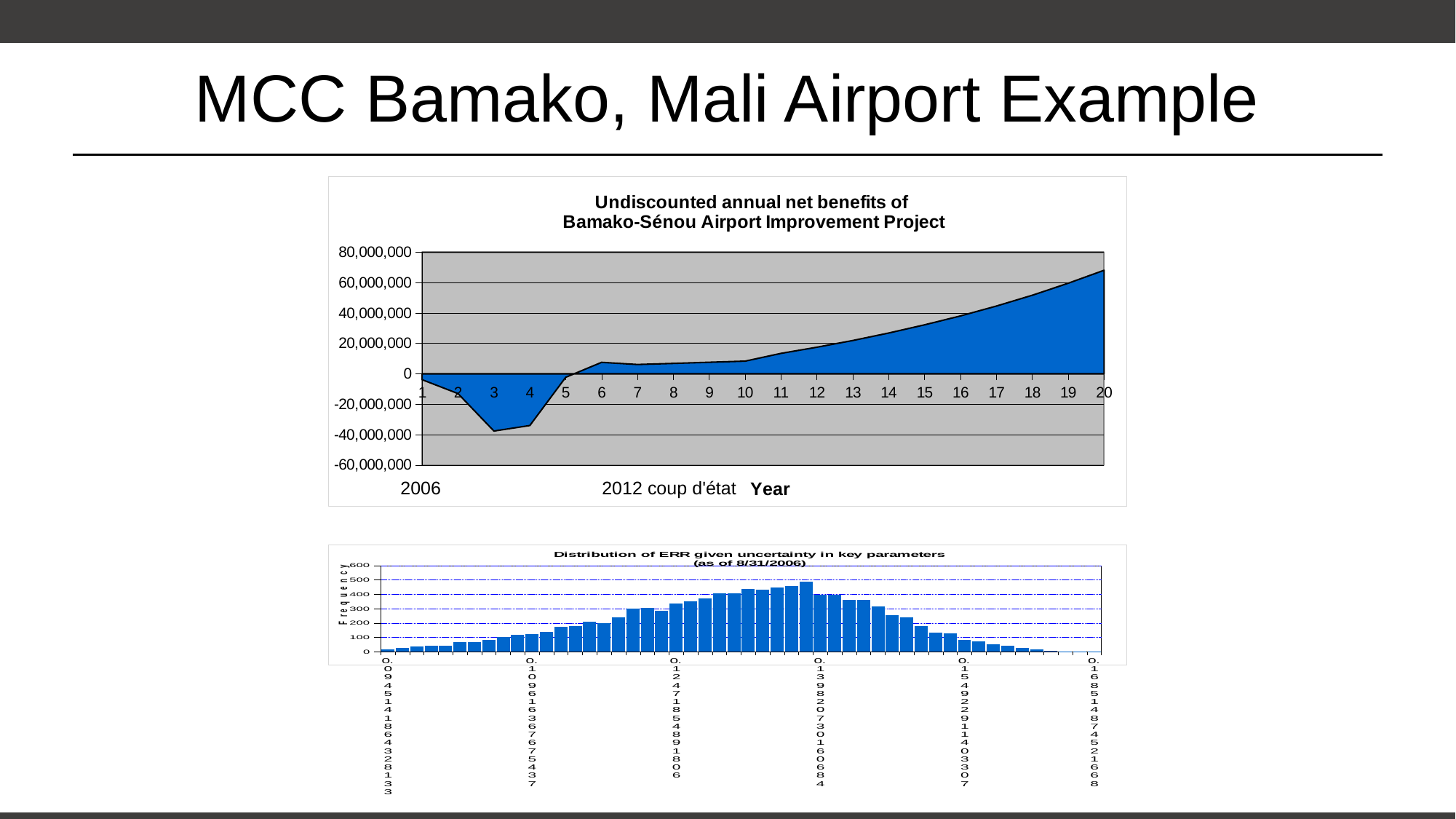
In the top chart, is the value for year 10 greater or less than 20,000,000? less What kind of chart is the bottom chart, 'Distribution of ERR given uncertainty in key parameters'? Bar chart In the top chart, is the value for year 20 greater or less than 60,000,000? greater In the top chart, which is larger, the value for year 15 or the value for year 8? Year 15 In the top chart, which year has the highest net benefit? 20 What is the label of the y axis on the bottom chart? Frequency In the top chart, which year has the lowest net benefit? 3 In the top chart, is the value for year 3 greater or less than -20,000,000? less In the top chart, how many years are shown on the x axis? 20 In the top chart, do the net benefits rise or fall from year 5 to year 20? Rise What kind of chart is the top chart, 'Undiscounted annual net benefits of Bamako-Sénou Airport Improvement Project'? Area chart